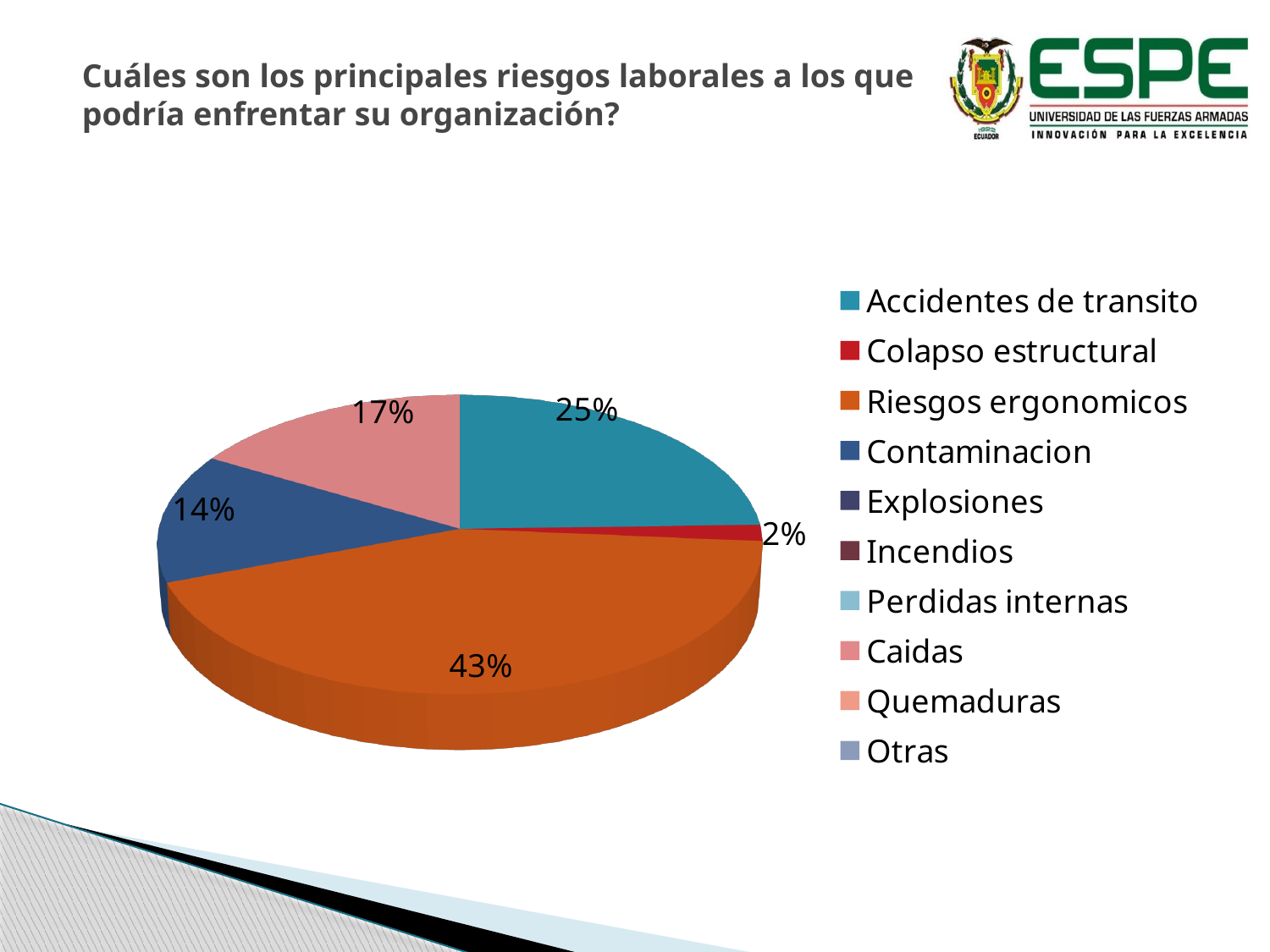
Which labelled slice is the smallest in the pie? Colapso estructural Which is larger, the share for Caidas or the share for Contaminacion? Caidas How many entries does the legend list? 10 What share of the pie does Caidas have? 17% What kind of chart is shown on the slide? pie chart What share of the pie does Colapso estructural have? 2% What colour is the slice for Riesgos ergonomicos? orange What share of the pie does Riesgos ergonomicos have? 43% What is the difference in percentage points between Riesgos ergonomicos and Accidentes de transito? 18 Which category has the largest slice of the pie? Riesgos ergonomicos